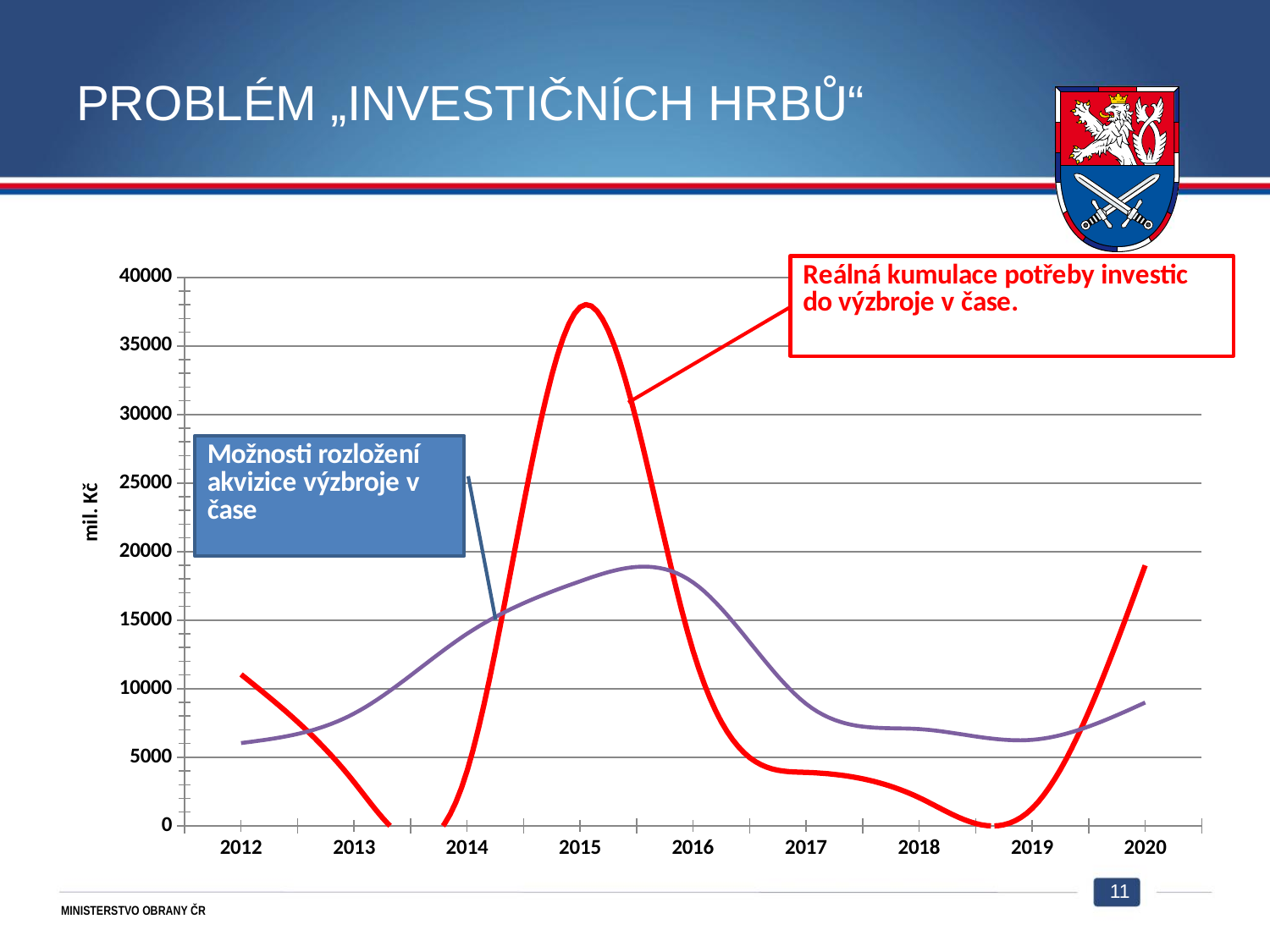
In which year does the red line (Reálná kumulace potřeby investic) reach its highest value? 2015 Is the value of the purple line (Možnosti rozložení akvizice výzbroje) in 2014 greater or less than 10000? greater What kind of chart is shown on the slide? line chart Does the red line (Reálná kumulace potřeby investic) rise or fall between 2015 and 2018? fall Is the value of the purple line (Možnosti rozložení akvizice výzbroje) in 2018 greater or less than 10000? less Is the value of the red line (Reálná kumulace potřeby investic) in 2015 greater or less than 35000? greater In 2017, which line has the higher value: the red line (Reálná kumulace potřeby investic) or the purple line (Možnosti rozložení akvizice výzbroje)? the purple line How many years are labelled on the x axis of the chart? 9 In 2015, which line has the higher value: the red line (Reálná kumulace potřeby investic) or the purple line (Možnosti rozložení akvizice výzbroje)? the red line What colour is the line labelled "Reálná kumulace potřeby investic do výzbroje v čase"? red What is the label of the vertical axis of the chart? mil. Kč